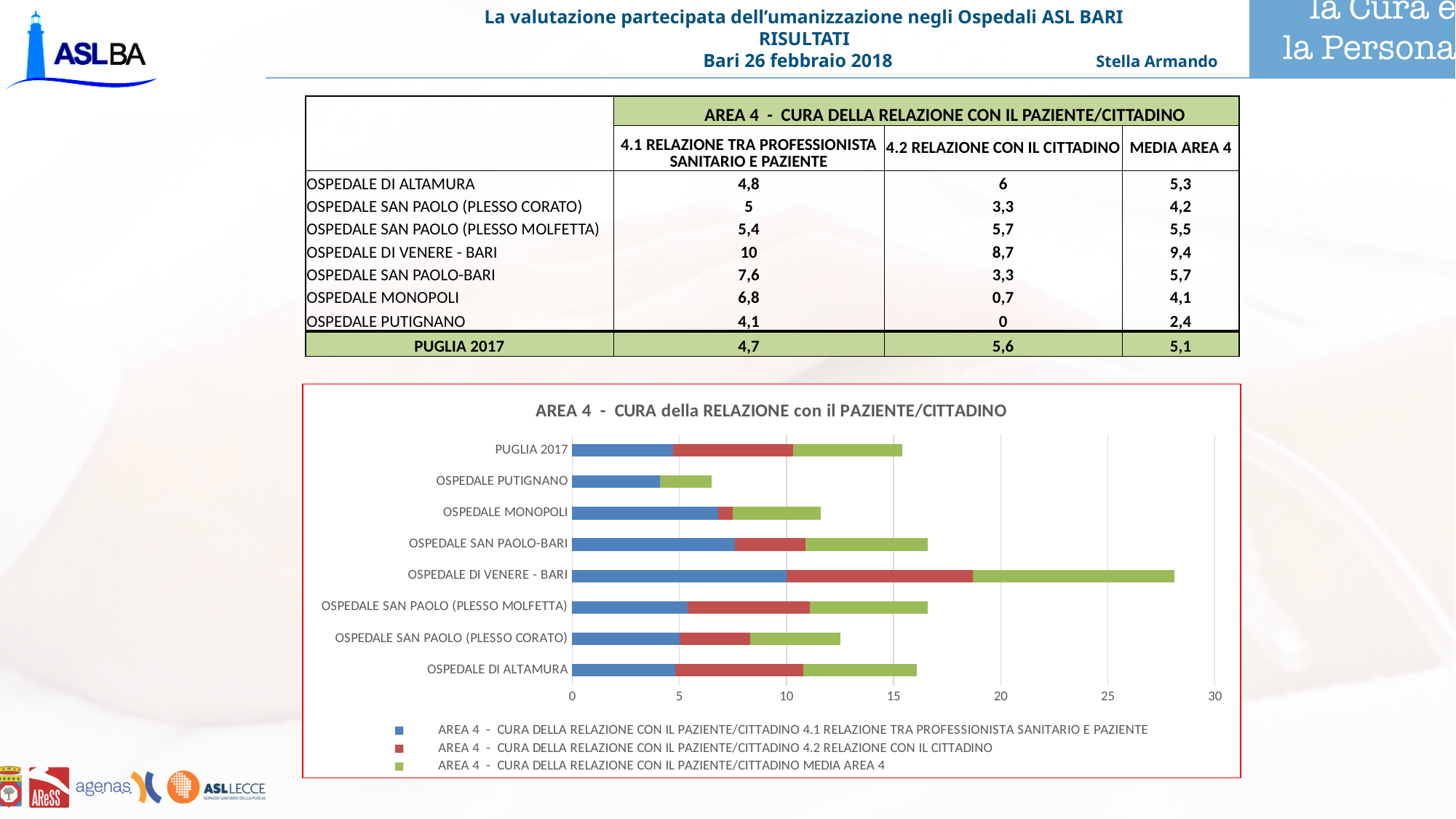
Is the total stacked bar for OSPEDALE PUTIGNANO greater or less than 10? less How many categories (hospitals/regions) are plotted on the chart? 8 What is the MEDIA AREA 4 value for PUGLIA 2017? 5,1 Is the total stacked bar for OSPEDALE DI VENERE - BARI greater or less than 25? greater Which has the longer stacked bar, OSPEDALE MONOPOLI or OSPEDALE SAN PAOLO-BARI? OSPEDALE SAN PAOLO-BARI Which category has the longest stacked bar in the chart? OSPEDALE DI VENERE - BARI What is the title of the chart? AREA 4 - CURA della RELAZIONE con il PAZIENTE/CITTADINO What kind of chart is shown on the slide? Stacked bar chart What is the total of the stacked bar for OSPEDALE DI VENERE - BARI (sum of 4.1, 4.2 and MEDIA AREA 4)? 28,1 Which category has the shortest stacked bar in the chart? OSPEDALE PUTIGNANO How many series does the chart legend list? 3 What is the value of 4.1 RELAZIONE TRA PROFESSIONISTA SANITARIO E PAZIENTE for OSPEDALE DI VENERE - BARI? 10